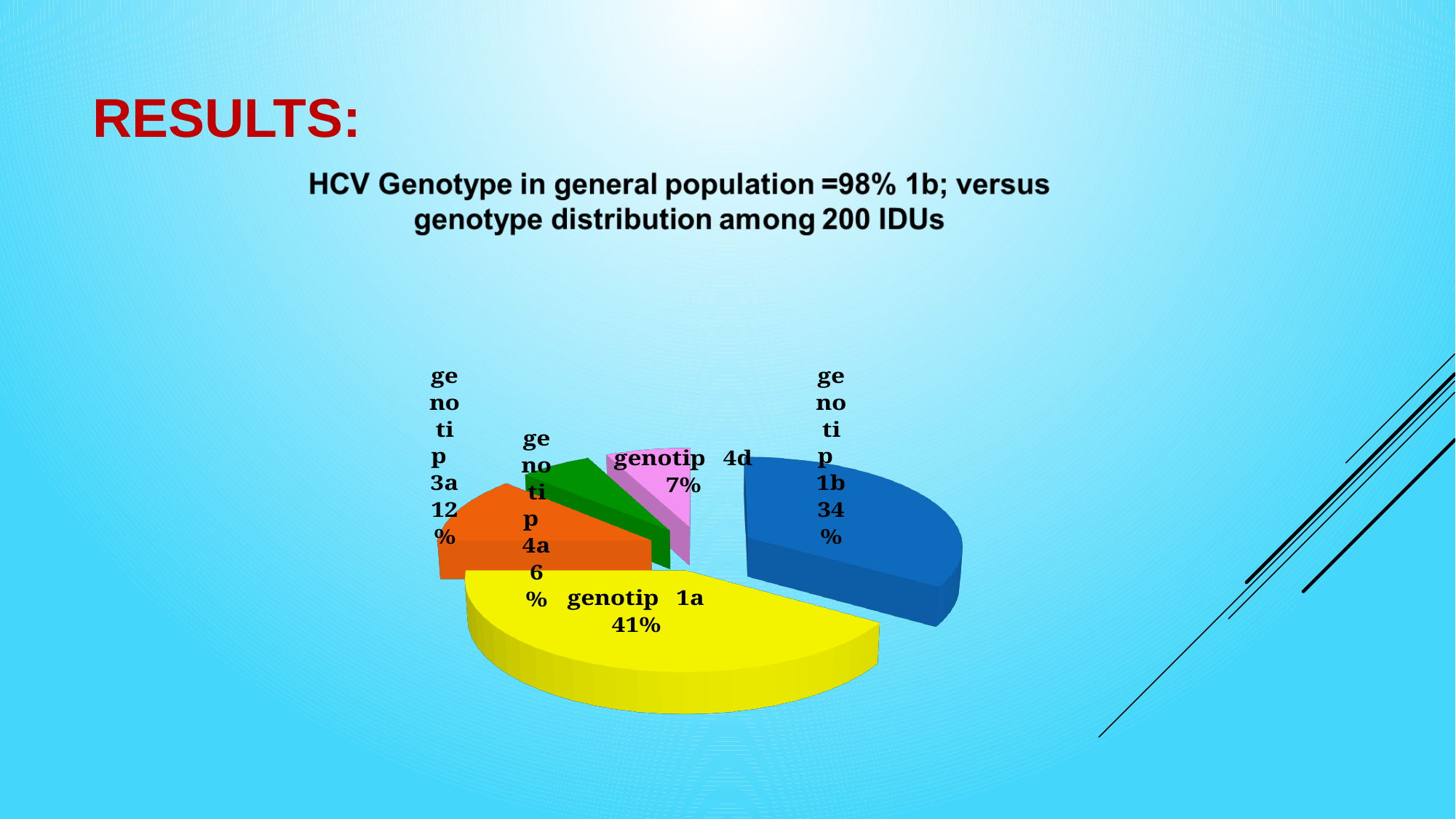
What percentage of the pie is genotip 3a? 12% What is the difference in percentage points between genotip 1a and genotip 1b? 7 What colour is the genotip 1b slice? blue What percentage of the pie is genotip 1a? 41% What kind of chart is shown on the slide? pie chart What percentage of the pie is genotip 4a? 6% Which has a larger share, genotip 3a or genotip 4d? genotip 3a Which genotype has the smallest share of the pie? genotip 4a Which genotype has the largest share of the pie? genotip 1a What percentage of the pie is genotip 1b? 34% What percentage of the pie is genotip 4d? 7% How many slices does the pie chart have? 5